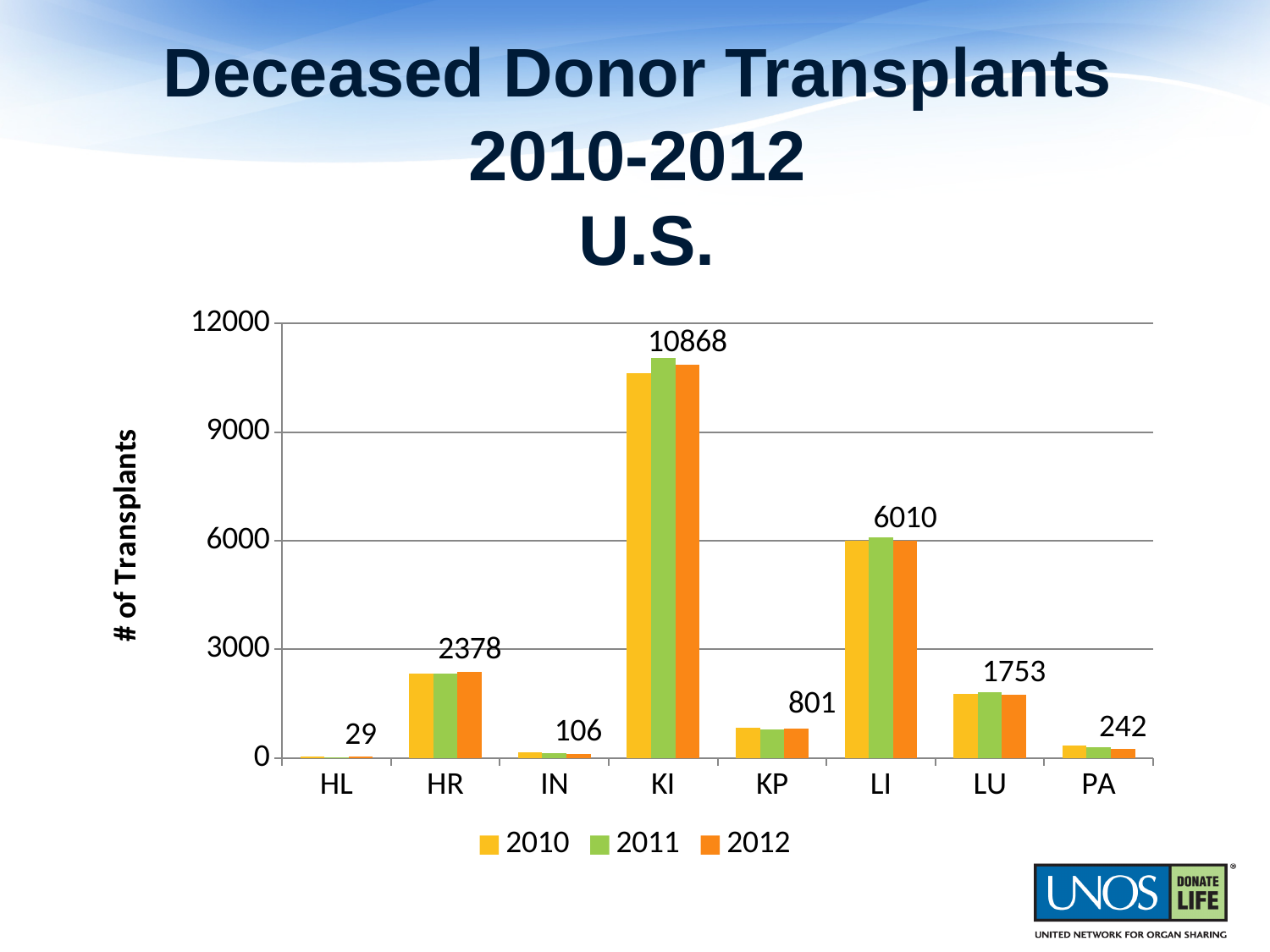
What value is labelled above the HL group of bars? 29 Which category has more transplants, HR or LU? HR What value is labelled above the KI group of bars? 10868 How many series does the legend list? 3 What is the title of the vertical axis? # of Transplants How many organ categories are shown on the x axis? 8 Which category has the lowest number of transplants? HL Which category has the highest number of transplants? KI What kind of chart is shown on the slide? bar chart Is the 2010 value for KI greater or less than 9000? greater What is the difference between the labelled values for LI and LU? 4257 What value is labelled above the LI group of bars? 6010